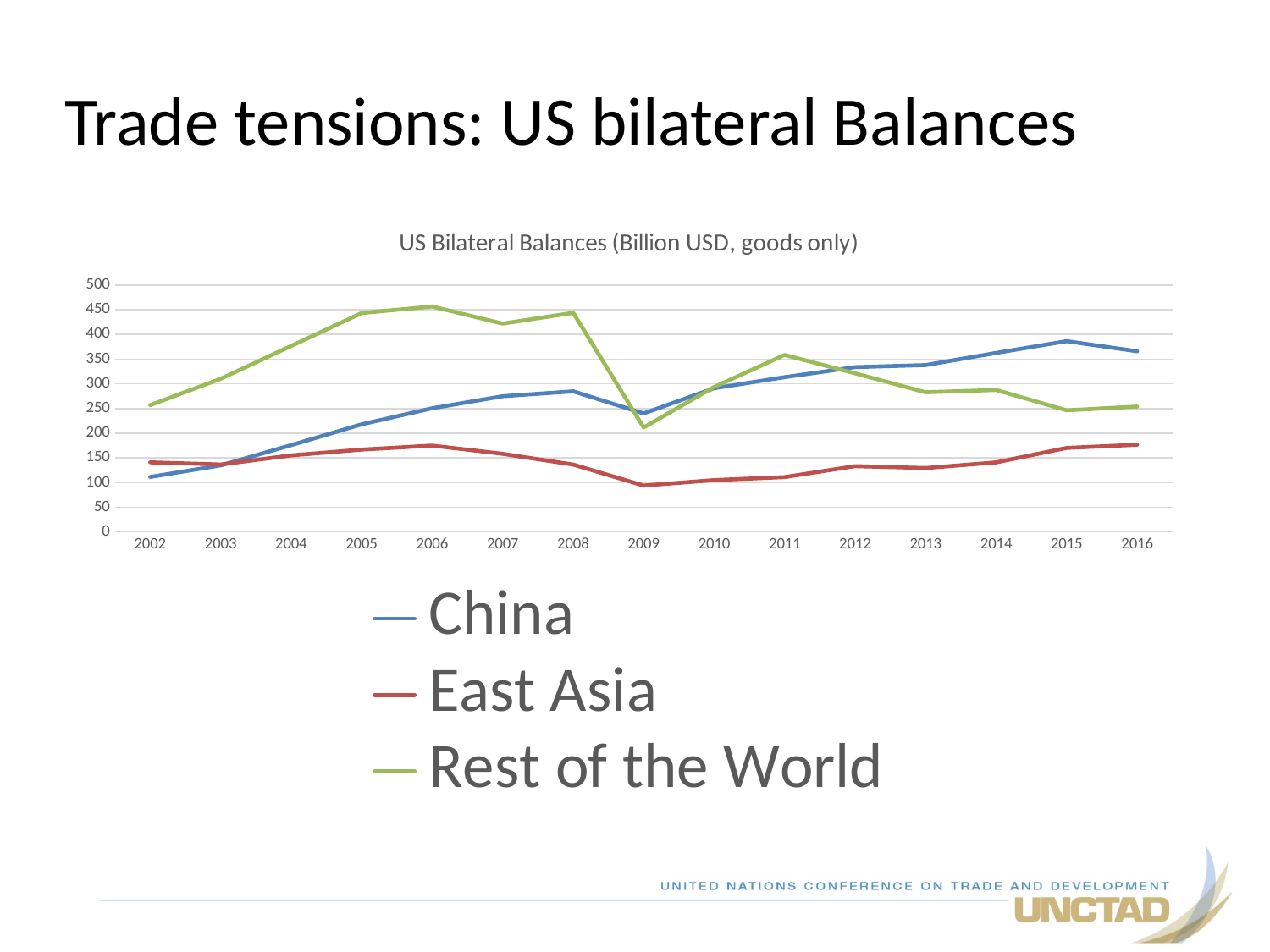
Is the value for China in 2015 greater or less than 350? greater Is the value for Rest of the World in 2009 greater or less than 250? less Is the value for Rest of the World in 2006 greater or less than 400? greater What is the title of the chart? US Bilateral Balances (Billion USD, goods only) Which series is drawn in green? Rest of the World Which series has the highest value in 2008? Rest of the World How many series does the legend list? 3 Which series has the lowest value in 2016? East Asia In 2016, which is larger: the value for China or the value for Rest of the World? China What kind of chart is shown on the slide? line chart How many years are plotted along the x axis? 15